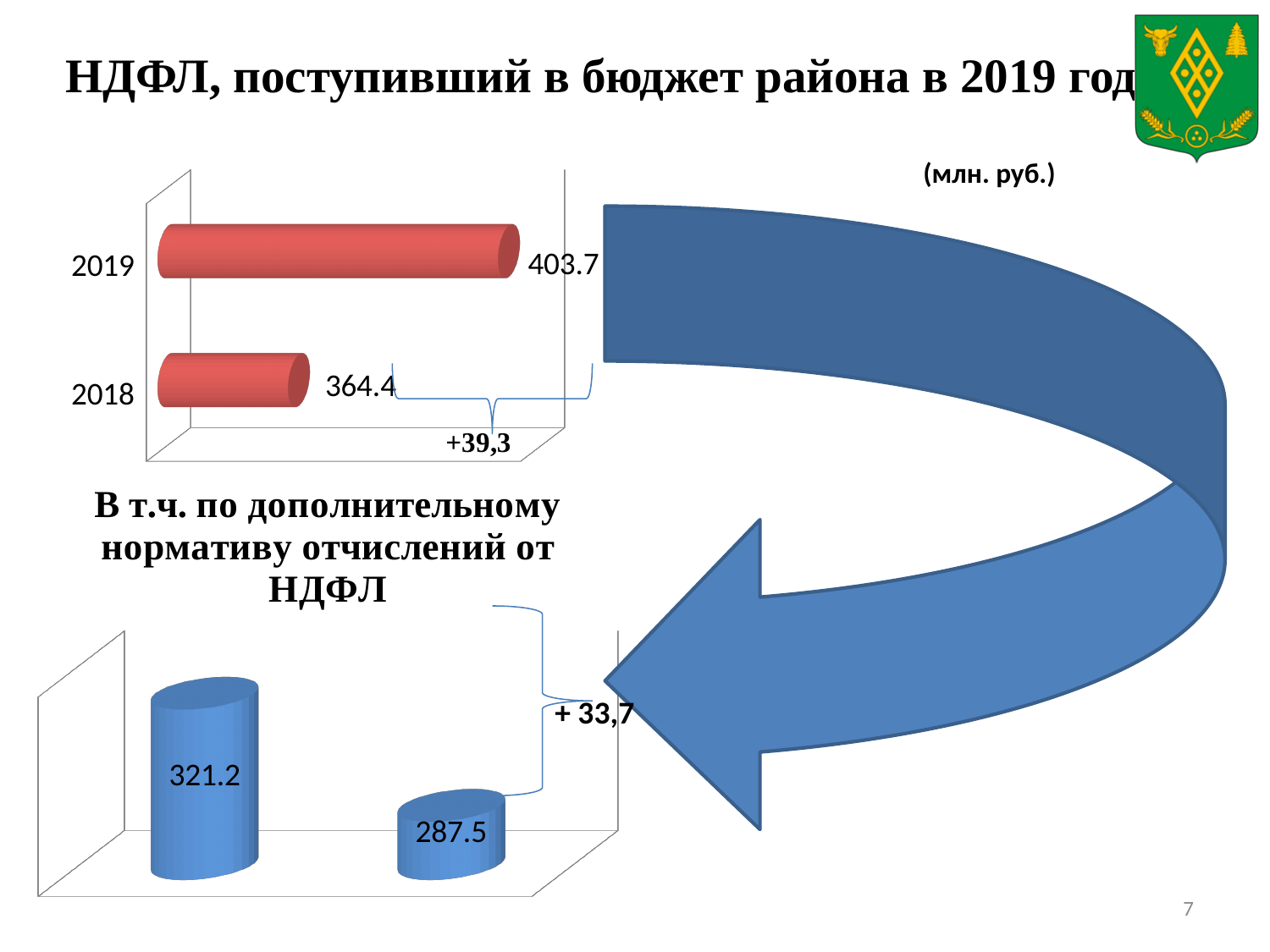
What kind of chart is the top chart? bar chart In the top chart, what is the value for 2019? 403.7 What unit of measurement is stated on the slide for the chart values? млн. руб. In the top chart, which year has the lower value? 2018 In the bottom chart (В т.ч. по дополнительному нормативу отчислений от НДФЛ), what is the value of the right bar? 287.5 In the bottom chart, what is the difference between the left bar and the right bar? 33.7 In the top chart, which year has the higher value? 2019 In the top chart, is the value for 2019 larger or smaller than the value for 2018? larger In the top chart, what is the difference between the 2019 and 2018 values? 39.3 In the top chart, what is the value for 2018? 364.4 How many bars are plotted in the top chart? 2 In the bottom chart (В т.ч. по дополнительному нормативу отчислений от НДФЛ), what is the value of the left bar? 321.2